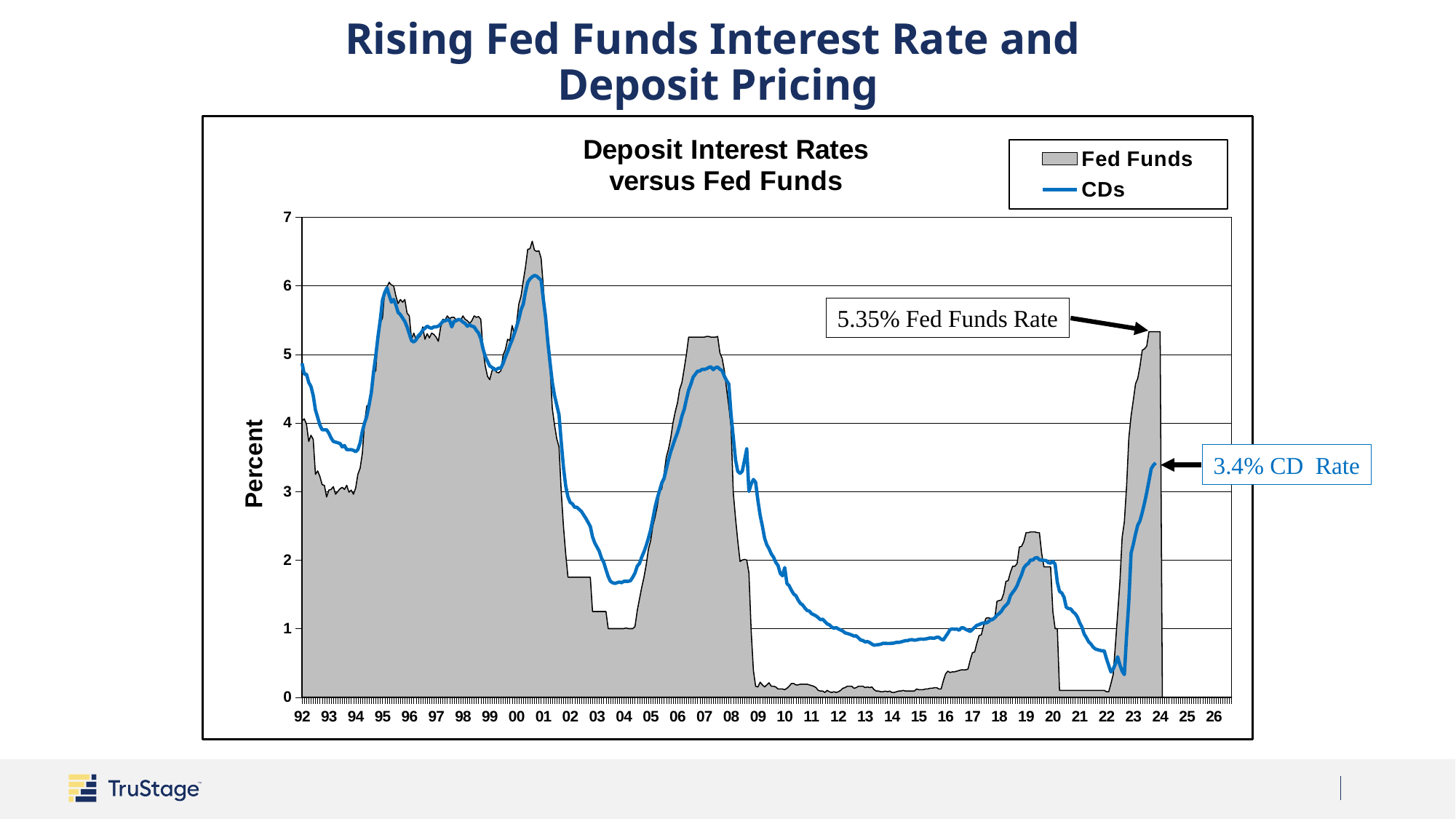
What is the title of the vertical axis? Percent What is the difference between the annotated 5.35% Fed Funds rate and the annotated 3.4% CD rate? 1.95% How many series does the legend list? 2 Is the Fed Funds value at its peak around 2000 greater or less than 6? greater At the annotated end point, which is higher, the Fed Funds rate or the CD rate? Fed Funds rate Is the CDs value in 2007 greater or less than 4? greater What are the two entries in the chart legend? Fed Funds and CDs What Fed Funds rate is annotated at the right end of the chart? 5.35% Is the Fed Funds value in 2012 greater or less than 1? less What CD rate is annotated at the right end of the chart? 3.4% How is the CDs series drawn on the chart? As a line From 2022 to 2024, does the CDs line rise or fall? rise